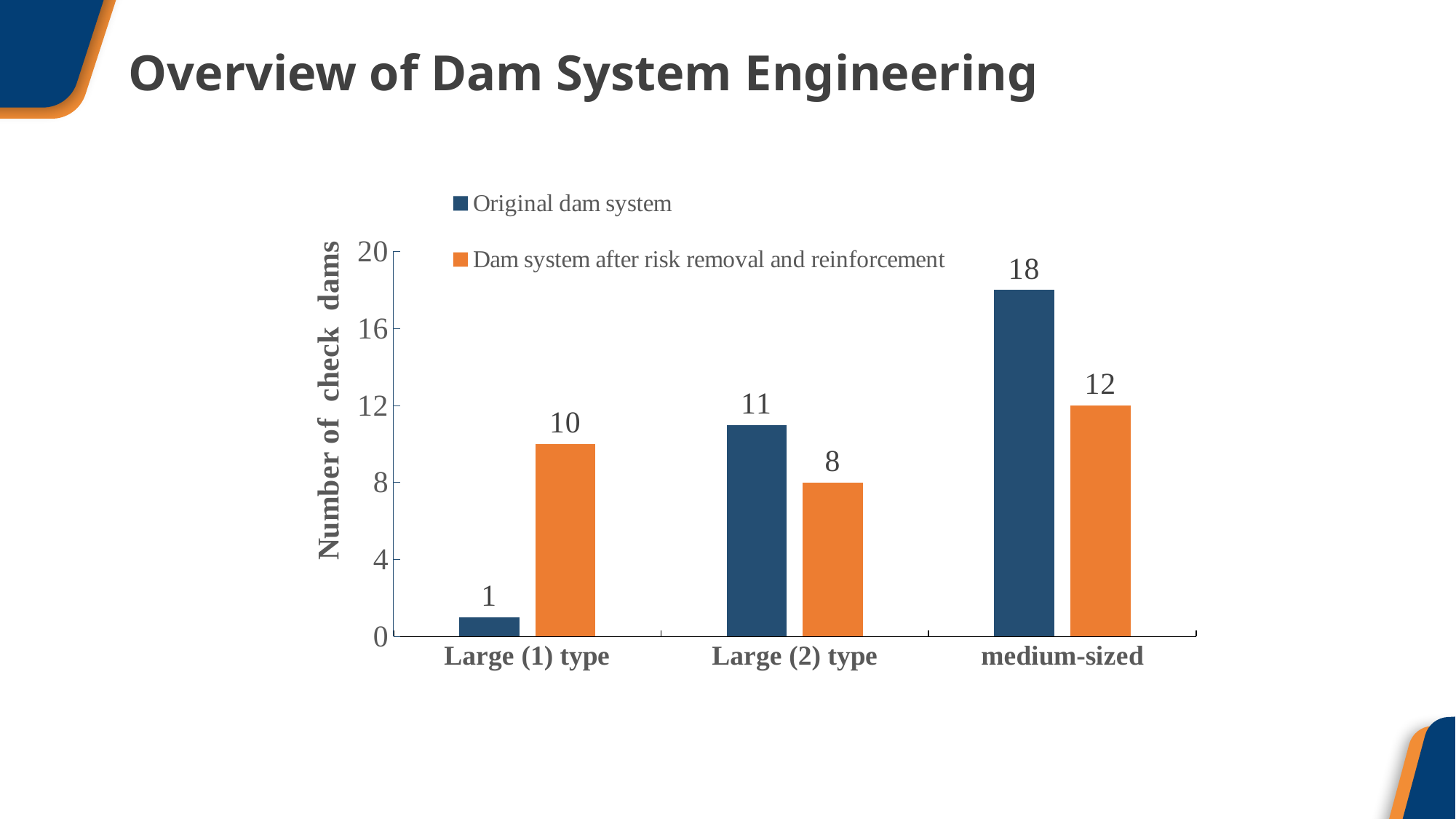
What is the value for medium-sized in the Dam system after risk removal and reinforcement series? 12 How many categories are shown on the x axis? 3 Which category has the highest value in the Original dam system series? medium-sized What kind of chart is shown on the slide? bar chart For Large (1) type, which series has the larger value: Original dam system or Dam system after risk removal and reinforcement? Dam system after risk removal and reinforcement Which category has the lowest value in the Dam system after risk removal and reinforcement series? Large (2) type How many series does the legend list? 2 What is the value for Large (2) type in the Original dam system series? 11 What is the value for Large (1) type in the Original dam system series? 1 What is the difference between the Original dam system and the Dam system after risk removal and reinforcement values for medium-sized? 6 What is the label of the y axis? Number of check dams Is the value for Large (2) type in the Dam system after risk removal and reinforcement series greater or less than 12? less